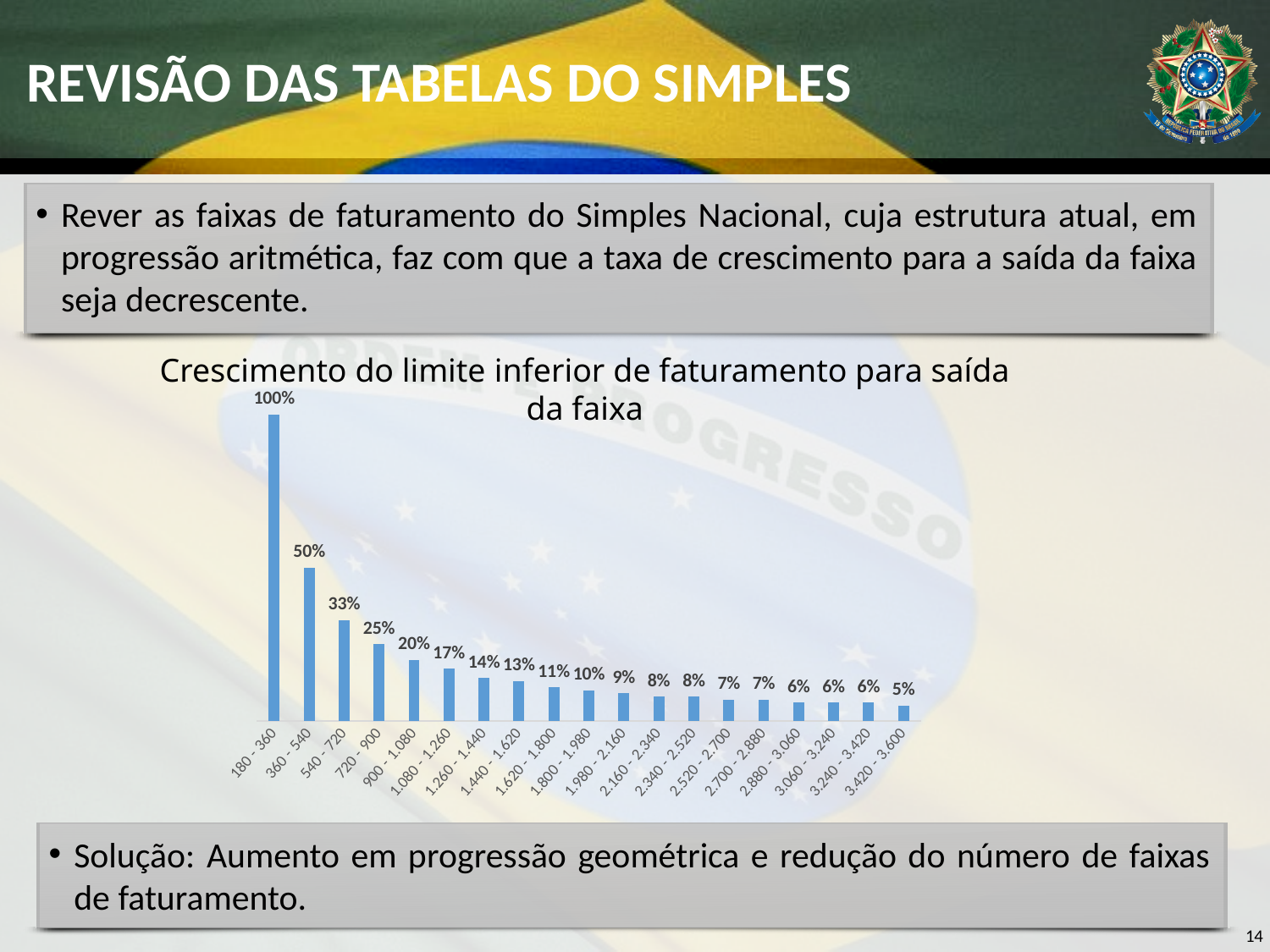
What kind of chart is shown on the slide? Bar chart What is the value for the 3.420 - 3.600 category? 5% Which is larger, the value for 720 - 900 or the value for 1.620 - 1.800? 720 - 900 Do the values rise or fall from left to right along the x axis? Fall What is the difference between the values for 180 - 360 and 360 - 540? 50% What is the title of the chart? Crescimento do limite inferior de faturamento para saída da faixa What is the value for the 180 - 360 category? 100% How many categories are shown on the x axis? 19 Which category has the lowest value? 3.420 - 3.600 What is the value for the 1.260 - 1.440 category? 14% Which category has the highest value? 180 - 360 What is the value for the 540 - 720 category? 33%